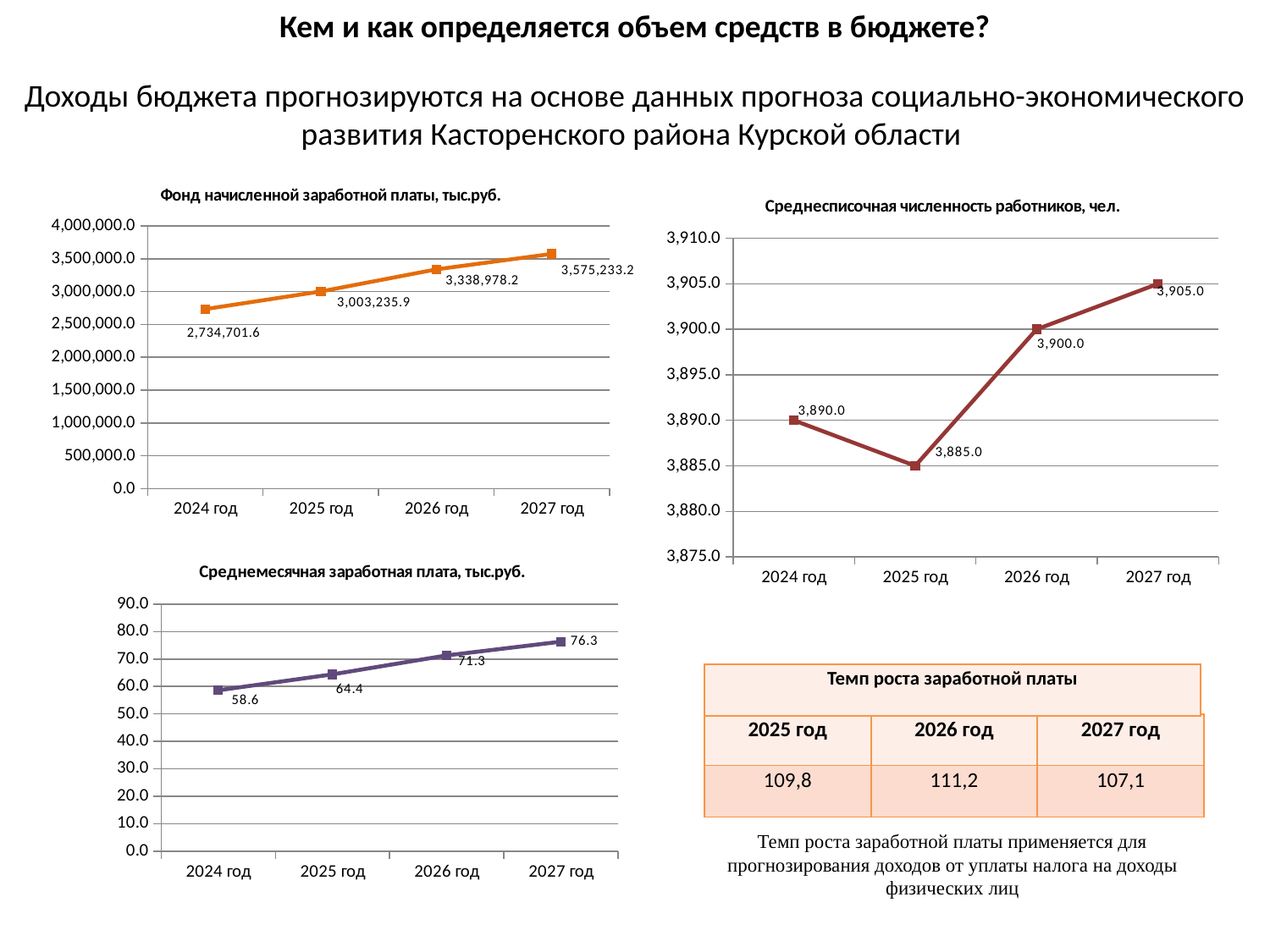
In the chart 'Среднесписочная численность работников, чел.', which year has the lowest value? 2025 год In the chart 'Среднесписочная численность работников, чел.', what is the value for 2025 год? 3,885.0 In the chart 'Среднемесячная заработная плата, тыс.руб.', what is the difference between the values for 2027 год and 2024 год? 17.7 In the chart 'Среднемесячная заработная плата, тыс.руб.', what is the value for 2026 год? 71.3 What kind of chart is 'Фонд начисленной заработной платы, тыс.руб.'? line chart How many years are plotted in the chart 'Среднесписочная численность работников, чел.'? 4 In the chart 'Фонд начисленной заработной платы, тыс.руб.', is the value for 2024 год greater or less than 3,000,000.0? less In the chart 'Среднесписочная численность работников, чел.', what is the difference between the values for 2027 год and 2025 год? 20.0 In the chart 'Среднемесячная заработная плата, тыс.руб.', do the values rise or fall from 2024 год to 2027 год? rise In the chart 'Фонд начисленной заработной платы, тыс.руб.', what is the value for 2025 год? 3,003,235.9 In the chart 'Среднемесячная заработная плата, тыс.руб.', which year has the highest value? 2027 год In the chart 'Фонд начисленной заработной платы, тыс.руб.', what is the value for 2027 год? 3,575,233.2